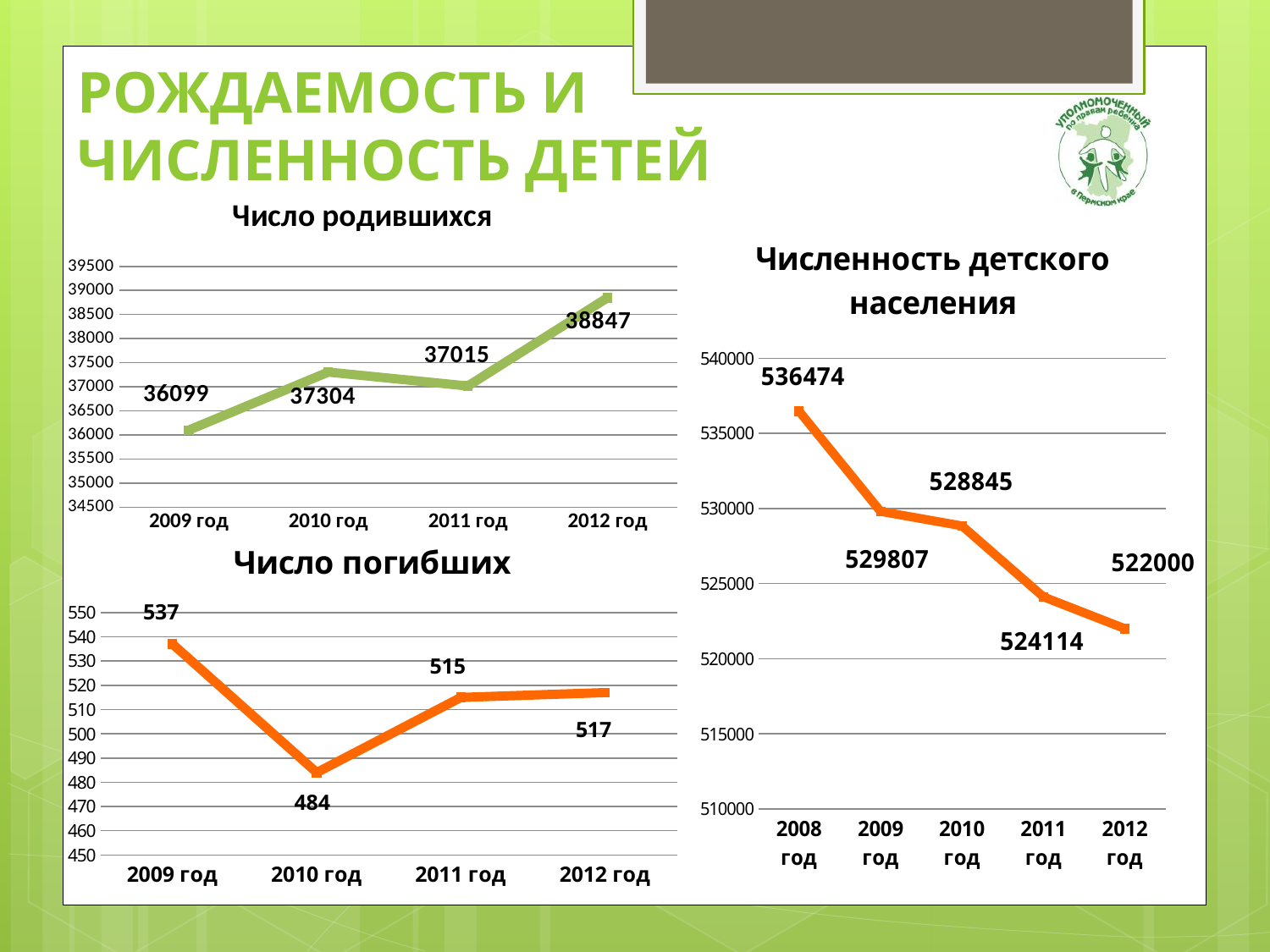
In the chart titled "Численность детского населения", do the values rise or fall from 2008 год to 2012 год? fall In the chart titled "Число погибших", which year has the highest value? 2009 год In the chart titled "Число родившихся", what is the difference between the values for 2012 год and 2009 год? 2748 What kind of chart is "Число погибших"? line chart In the chart titled "Число погибших", is the value for 2011 год larger or smaller than the value for 2009 год? smaller In the chart titled "Число погибших", what is the value for 2010 год? 484 In the chart titled "Численность детского населения", what is the difference between the values for 2008 год and 2012 год? 14474 In the chart titled "Число родившихся", how many data points are plotted? 4 In the chart titled "Численность детского населения", how many years are shown on the x axis? 5 In the chart titled "Численность детского населения", what is the value for 2008 год? 536474 In the chart titled "Число родившихся", which year has the lowest value? 2009 год In the chart titled "Число родившихся", what is the value for 2012 год? 38847